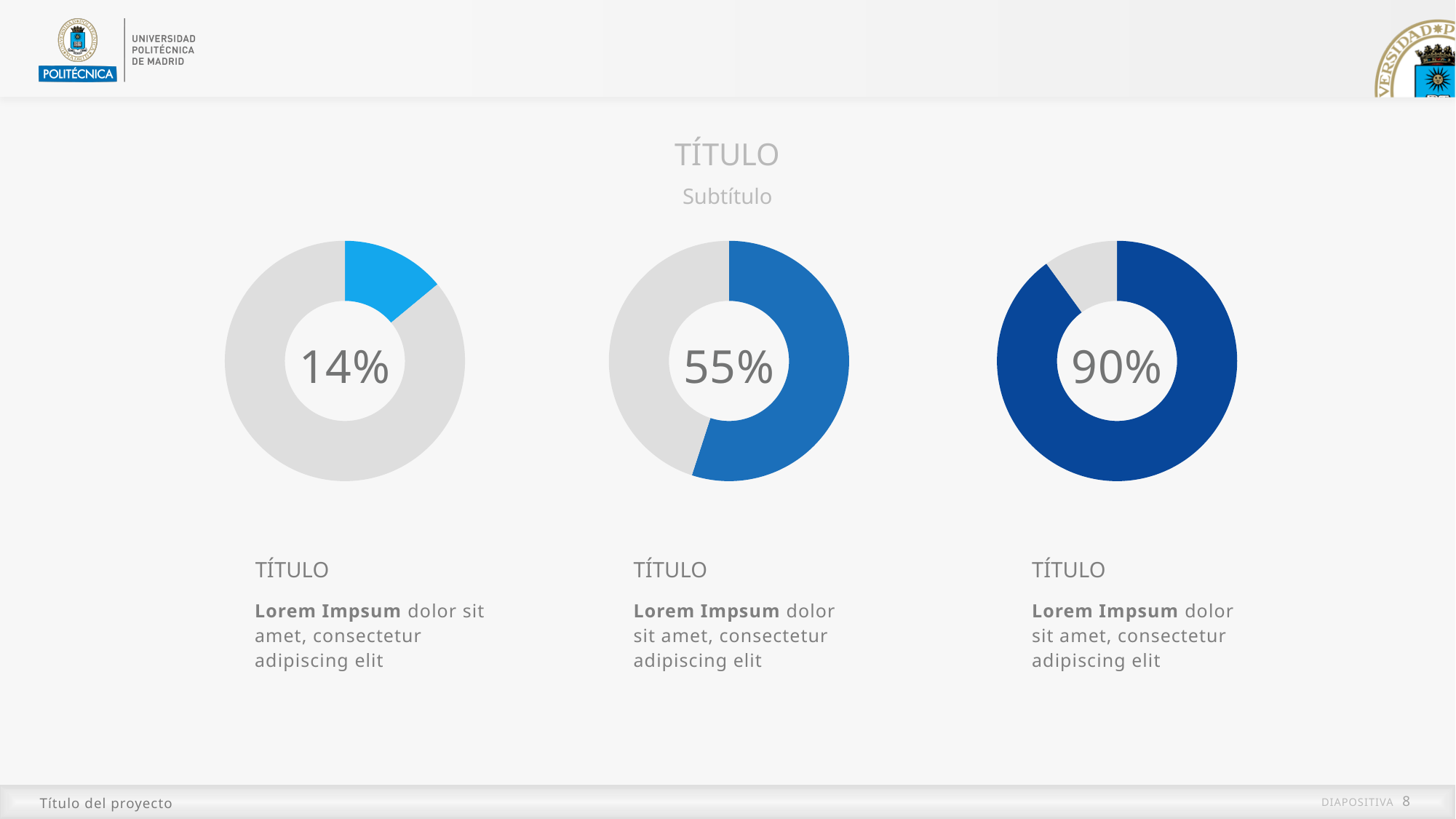
Which of the three donut charts shows the lowest percentage? The left chart (14%) What percentage is shown in the centre of the left donut chart? 14% Which shows a larger percentage, the middle donut chart or the right donut chart? The right chart What kind of chart is used for each of the three figures on the slide? Donut (pie) chart How many donut charts are shown on the slide? 3 Which of the three donut charts shows the highest percentage? The right chart (90%) What is the difference between the percentage in the middle donut chart and the percentage in the left donut chart? 41% What colour is the filled segment of the left donut chart? Light blue What is the difference between the percentage in the right donut chart and the percentage in the left donut chart? 76% What percentage is shown in the centre of the middle donut chart? 55% What percentage is shown in the centre of the right donut chart? 90% What share of the middle donut chart is filled with the coloured segment? 55%